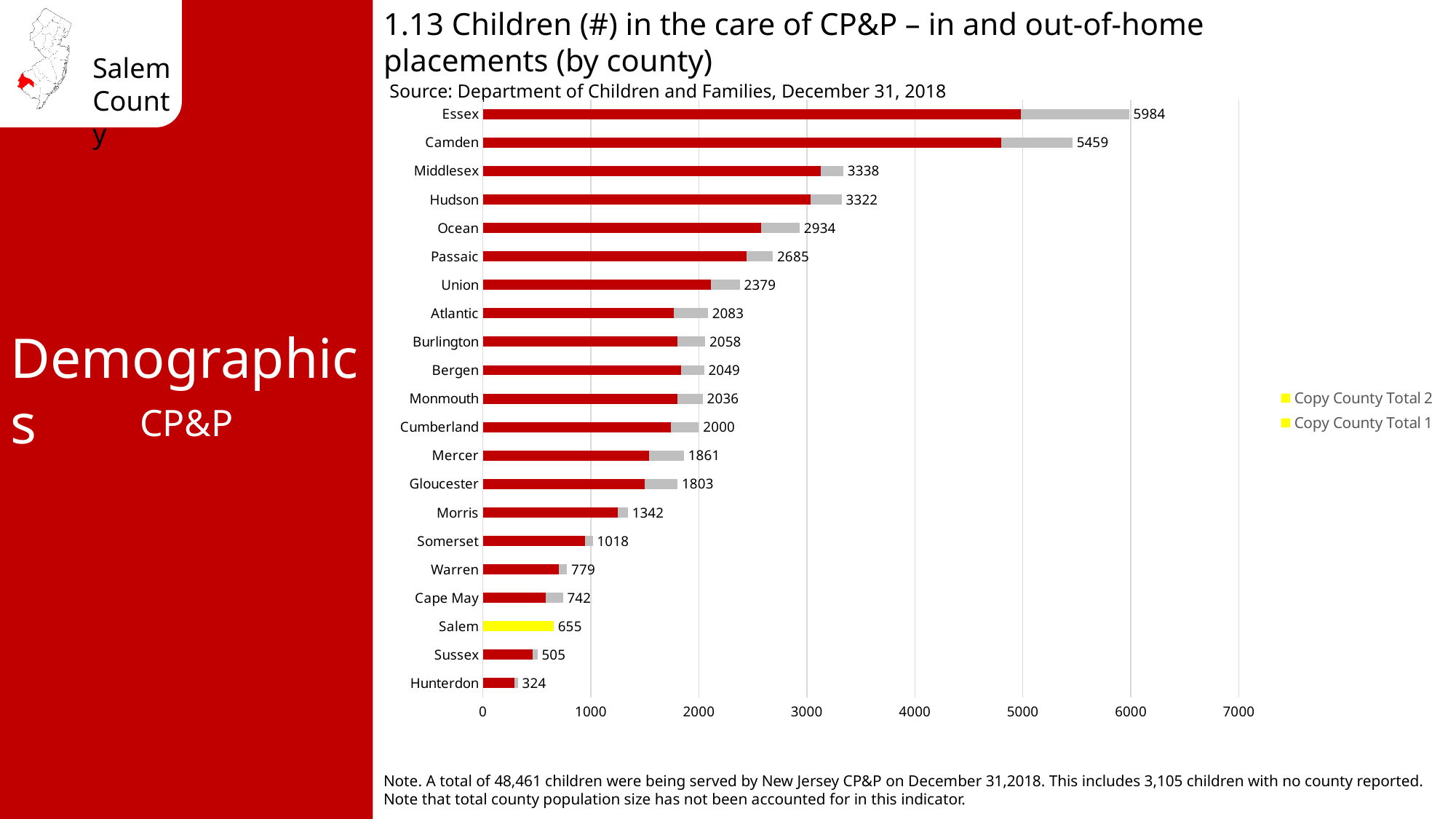
What is the total number of children in the care of CP&P for Cumberland County? 2000 How many counties are shown in the chart? 21 Which county has the lowest total number of children in the care of CP&P? Hunterdon What kind of chart is shown on the slide? Stacked bar chart What is the difference between the totals for Essex and Camden? 525 What is the total number of children in the care of CP&P for Essex County? 5984 Is the total for Gloucester greater or less than 2000? less How many series does the legend list? 2 Which county has the highest total number of children in the care of CP&P? Essex What is the total number of children in the care of CP&P for Salem County? 655 What is the difference between the totals for Salem and Sussex? 150 Which county has a larger total, Middlesex or Ocean? Middlesex